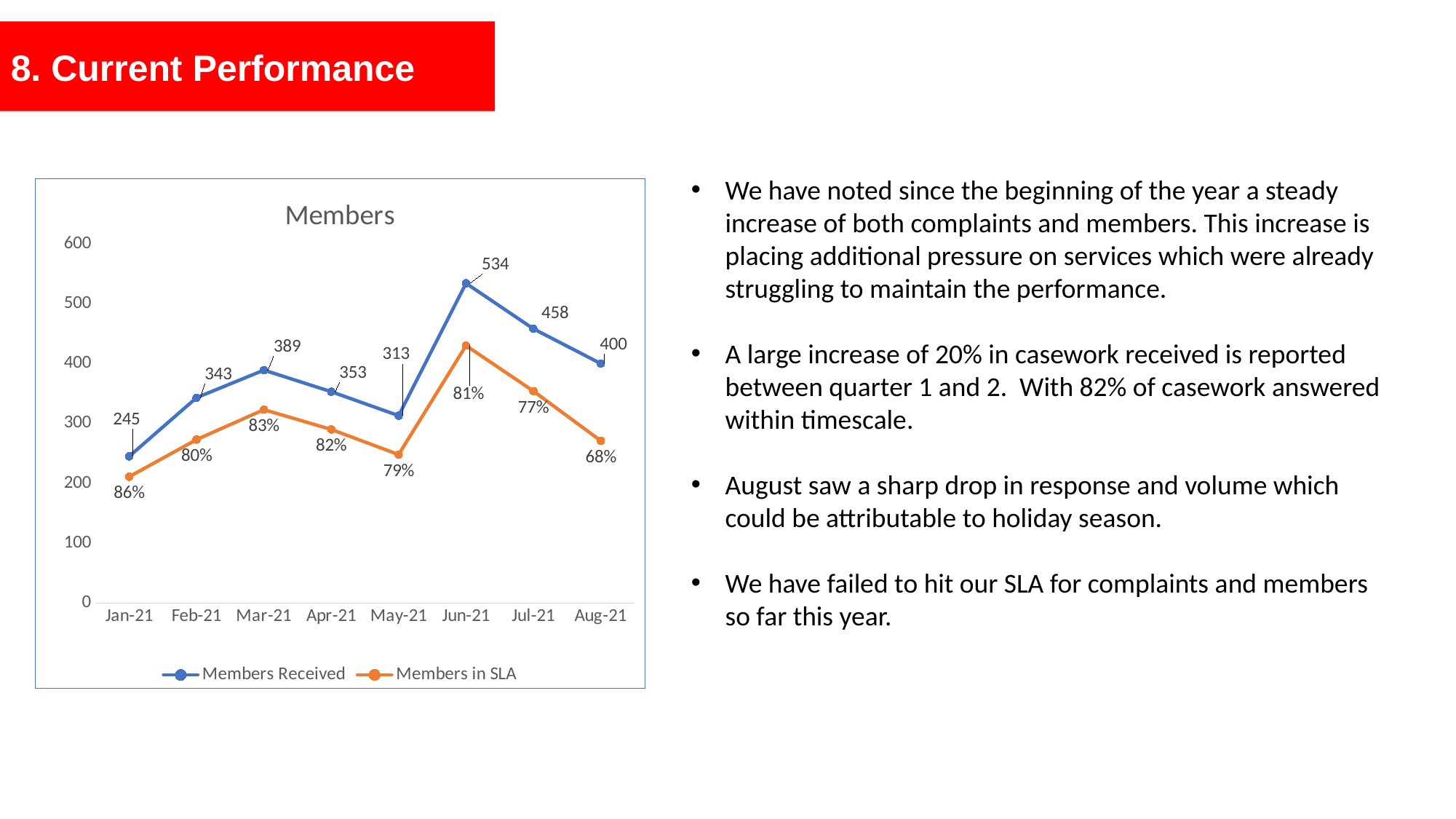
What label is shown for Members in SLA in Mar-21? 83% What is the Members Received value for Jan-21? 245 What label is shown for Members in SLA in Aug-21? 68% What type of chart is shown on the slide? line chart What is the difference in Members Received between Jun-21 and Jul-21? 76 How many months are plotted along the x axis of the chart? 8 How many series does the chart legend list? 2 Which month has the higher Members Received value, Mar-21 or Apr-21? Mar-21 In which month is Members Received lowest? Jan-21 What is the title of the chart? Members In which month is Members Received highest? Jun-21 What is the Members Received value for Jun-21? 534